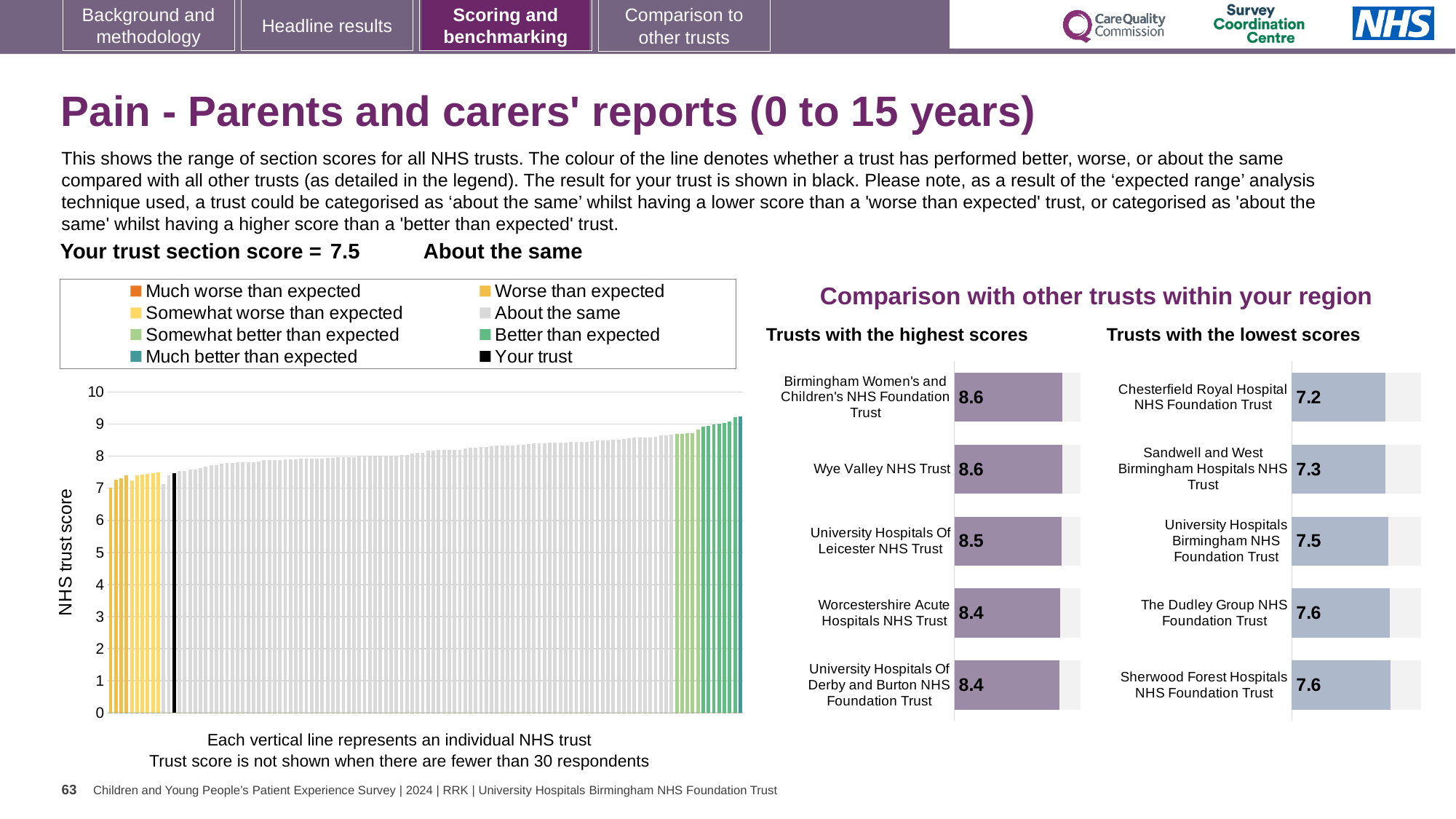
What is the title of the section containing the two small bar charts on the right of the slide? Comparison with other trusts within your region In the 'Trusts with the highest scores' chart, what is the difference between the scores of Birmingham Women's and Children's NHS Foundation Trust and Worcestershire Acute Hospitals NHS Trust? 0.2 In the 'Trusts with the lowest scores' chart, which has the higher score: Sandwell and West Birmingham Hospitals NHS Trust or The Dudley Group NHS Foundation Trust? The Dudley Group NHS Foundation Trust In the 'Trusts with the highest scores' chart, what is the score for Wye Valley NHS Trust? 8.6 How many entries does the legend above the large 'NHS trust score' chart list? 8 In the 'Trusts with the lowest scores' chart, what is the score for Chesterfield Royal Hospital NHS Foundation Trust? 7.2 In the 'Trusts with the lowest scores' chart, which trust has the lowest score? Chesterfield Royal Hospital NHS Foundation Trust In the large 'NHS trust score' chart on the left, do the bar heights rise or fall from left to right? Rise What kind of chart is the large 'NHS trust score' chart on the left of the slide? Bar chart How many trusts are listed in the 'Trusts with the highest scores' chart? 5 In the large 'NHS trust score' chart on the left, is the value of the tallest bar greater or less than 9? greater What is the section score for your trust shown on the slide? 7.5